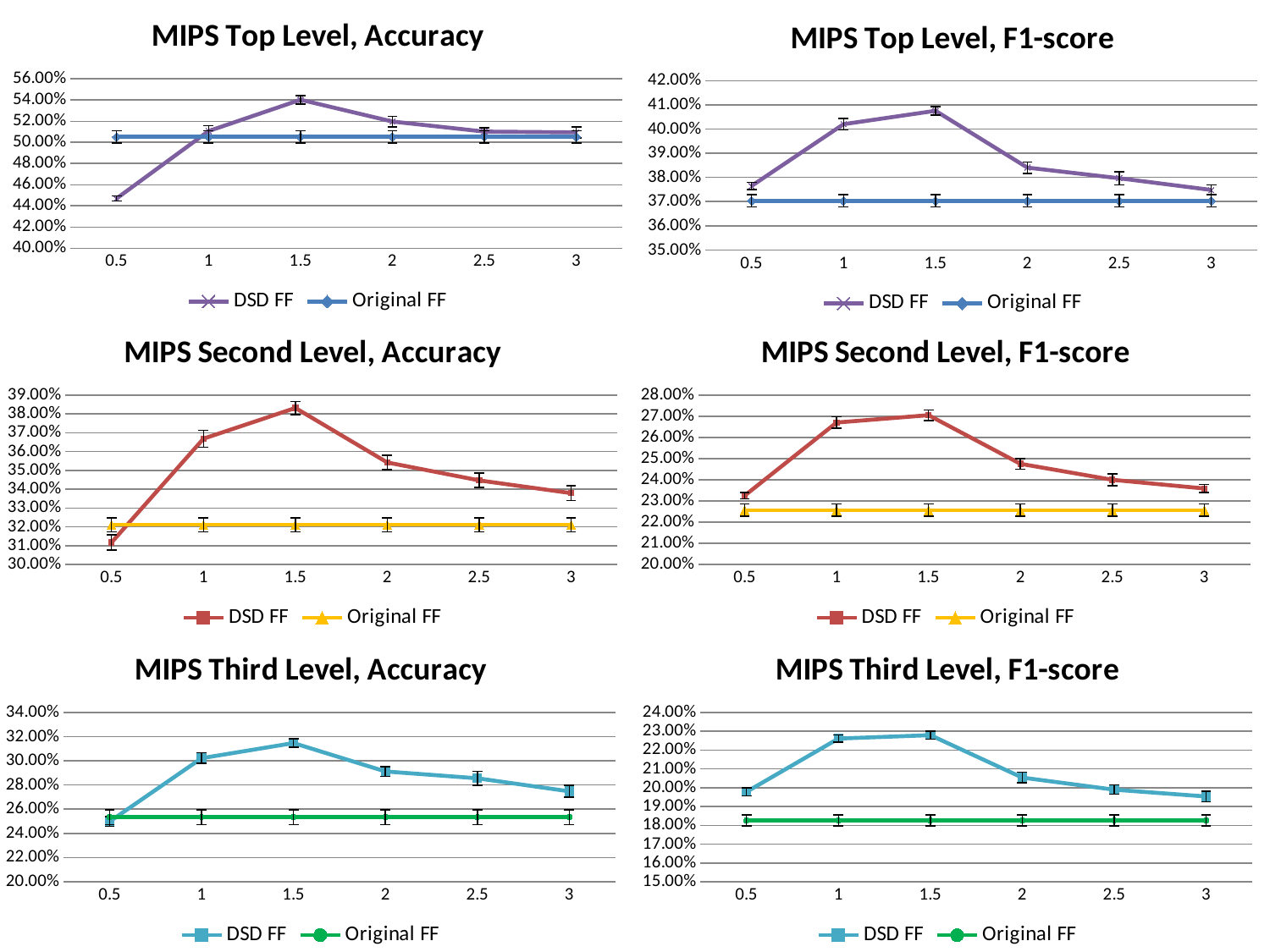
In "MIPS Second Level, F1-score", is the Original FF line greater or less than 23.00%? less In "MIPS Top Level, Accuracy", is the DSD FF value at 0.5 greater or less than 46.00%? less In "MIPS Second Level, Accuracy", at x = 0.5, which series has the higher value, DSD FF or Original FF? Original FF In "MIPS Third Level, Accuracy", is the DSD FF value at 1.5 greater or less than 30.00%? greater In "MIPS Top Level, Accuracy", at which x value does the DSD FF line reach its highest point? 1.5 How many x-axis points are plotted in "MIPS Second Level, Accuracy"? 6 What are the two legend entries shown in "MIPS Third Level, Accuracy"? DSD FF and Original FF In "MIPS Top Level, Accuracy", at which x value is the DSD FF line lowest? 0.5 How many series does the legend of "MIPS Top Level, Accuracy" list? 2 What kind of chart is "MIPS Top Level, Accuracy"? line chart In "MIPS Third Level, F1-score", does the DSD FF line rise or fall from x = 1.5 to x = 3? fall